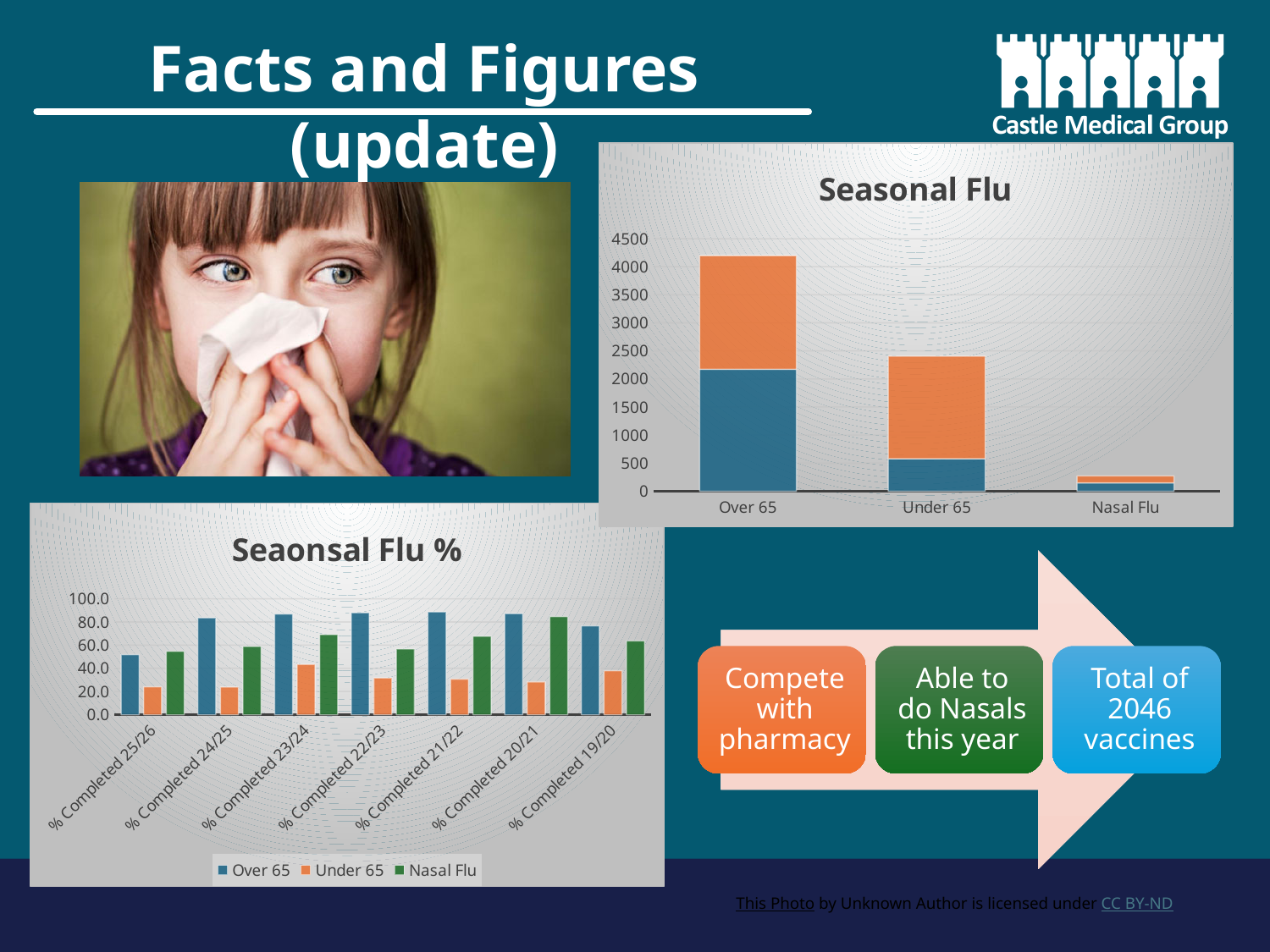
What type of chart is the 'Seasonal Flu' chart? bar chart How many categories are shown on the x axis of the 'Seaonsal Flu %' chart? 7 In the 'Seasonal Flu' chart, is the total stacked value for Under 65 greater or less than 3000? less In the 'Seaonsal Flu %' chart, which category has the lowest Over 65 value? % Completed 25/26 In the 'Seasonal Flu' chart, is the total stacked value for Over 65 greater or less than 4000? greater In the 'Seasonal Flu' chart, is the total stacked value for Nasal Flu greater or less than 500? less How many categories are shown on the x axis of the 'Seasonal Flu' chart? 3 In the 'Seasonal Flu' chart, which category has the shortest stacked bar? Nasal Flu In the 'Seasonal Flu' chart, which category has the tallest stacked bar? Over 65 In the 'Seaonsal Flu %' chart, which category has the highest Under 65 value? % Completed 23/24 How many series does the legend of the 'Seaonsal Flu %' chart list? 3 In the 'Seaonsal Flu %' chart, for % Completed 23/24, which is larger: Over 65 or Under 65? Over 65